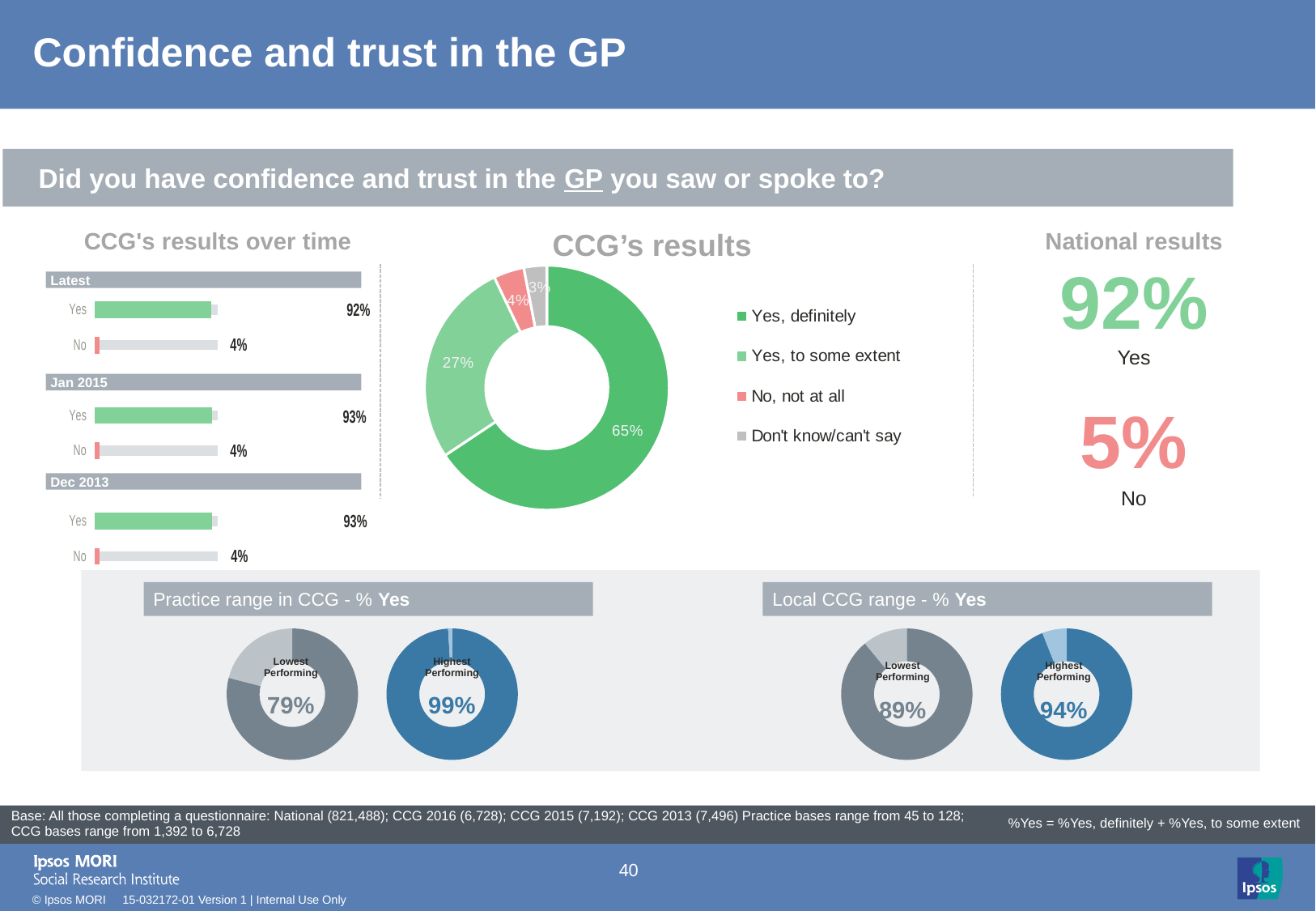
In the 'CCG's results' donut chart, which category has the smallest share? Don't know/can't say In the 'CCG's results' donut chart, what is the difference between 'Yes, definitely' and 'Yes, to some extent'? 38% In the 'CCG's results' donut chart, which category has the largest share? Yes, definitely What kind of chart is 'CCG's results over time'? Bar chart In the 'CCG's results' donut chart, what percentage answered 'Yes, definitely'? 65% In the 'CCG's results over time' chart, what is the 'No' value for Dec 2013? 4% In the 'Local CCG range - % Yes' section, what is the difference between the Highest Performing and Lowest Performing values? 5% In the 'CCG's results over time' chart, what is the 'Yes' value for Jan 2015? 93% How many entries does the legend of the 'CCG's results' donut chart list? 4 In the 'Practice range in CCG - % Yes' section, what is the value for the Highest Performing practice? 99% In the 'CCG's results' donut chart, what percentage answered 'Yes, to some extent'? 27% In the 'CCG's results over time' chart, what is the 'Yes' value for Latest? 92%